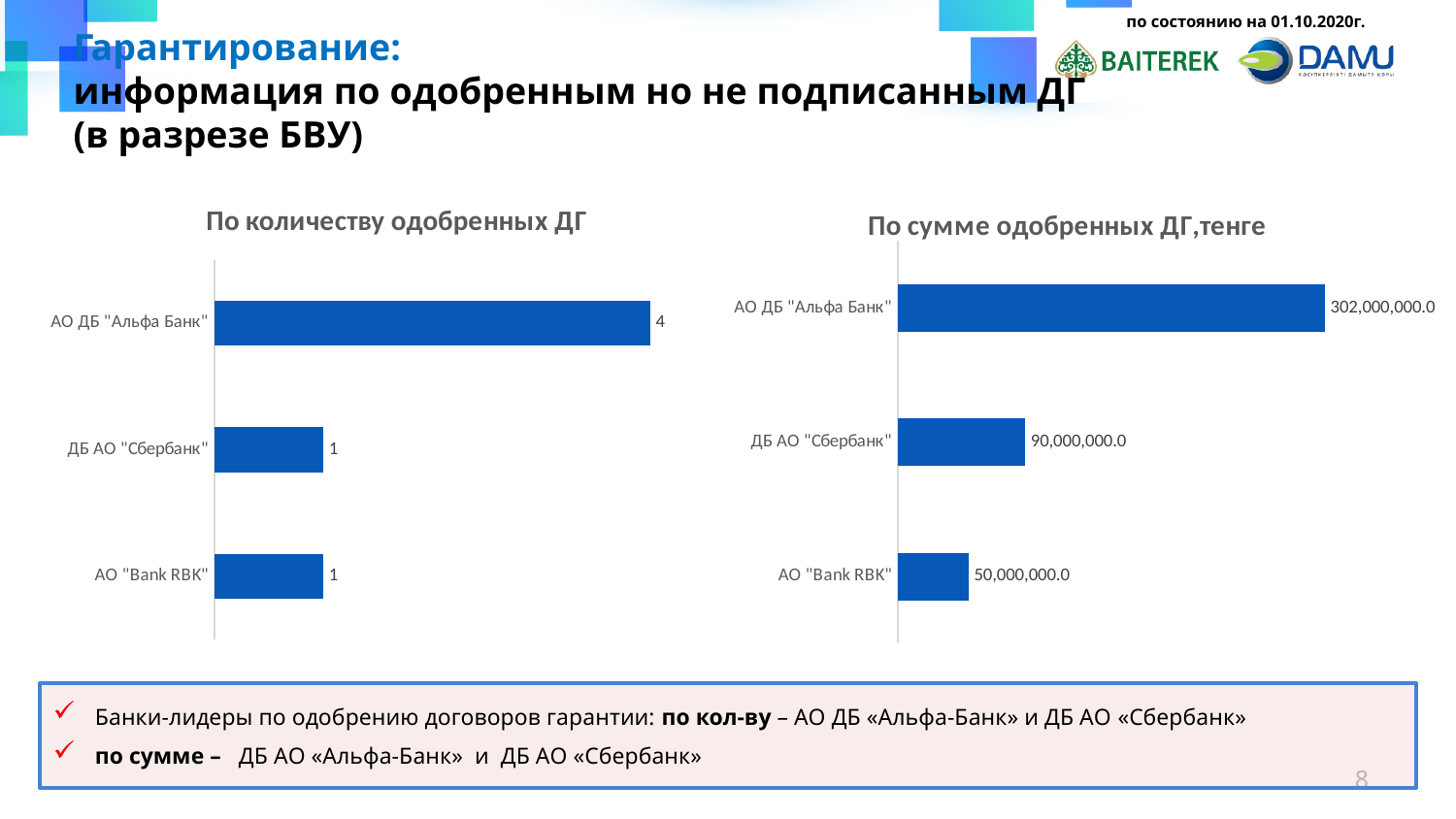
In the chart "По сумме одобренных ДГ,тенге", which bank has the highest value? АО ДБ "Альфа Банк" In the chart "По количеству одобренных ДГ", what is the value for АО ДБ "Альфа Банк"? 4 What is the title of the chart on the left side of the slide? По количеству одобренных ДГ What kind of chart is "По сумме одобренных ДГ,тенге"? bar chart In the chart "По количеству одобренных ДГ", what is the difference between АО ДБ "Альфа Банк" and АО "Bank RBK"? 3 In the chart "По сумме одобренных ДГ,тенге", what is the value for АО "Bank RBK"? 50,000,000.0 In the chart "По сумме одобренных ДГ,тенге", what is the value for ДБ АО "Сбербанк"? 90,000,000.0 In the chart "По сумме одобренных ДГ,тенге", which bank has the lowest value? АО "Bank RBK" In the chart "По сумме одобренных ДГ,тенге", which is larger: ДБ АО "Сбербанк" or АО "Bank RBK"? ДБ АО "Сбербанк" In the chart "По количеству одобренных ДГ", which bank has the highest value? АО ДБ "Альфа Банк" How many banks are shown in the chart "По количеству одобренных ДГ"? 3 In the chart "По сумме одобренных ДГ,тенге", what is the difference between АО ДБ "Альфа Банк" and ДБ АО "Сбербанк"? 212,000,000.0